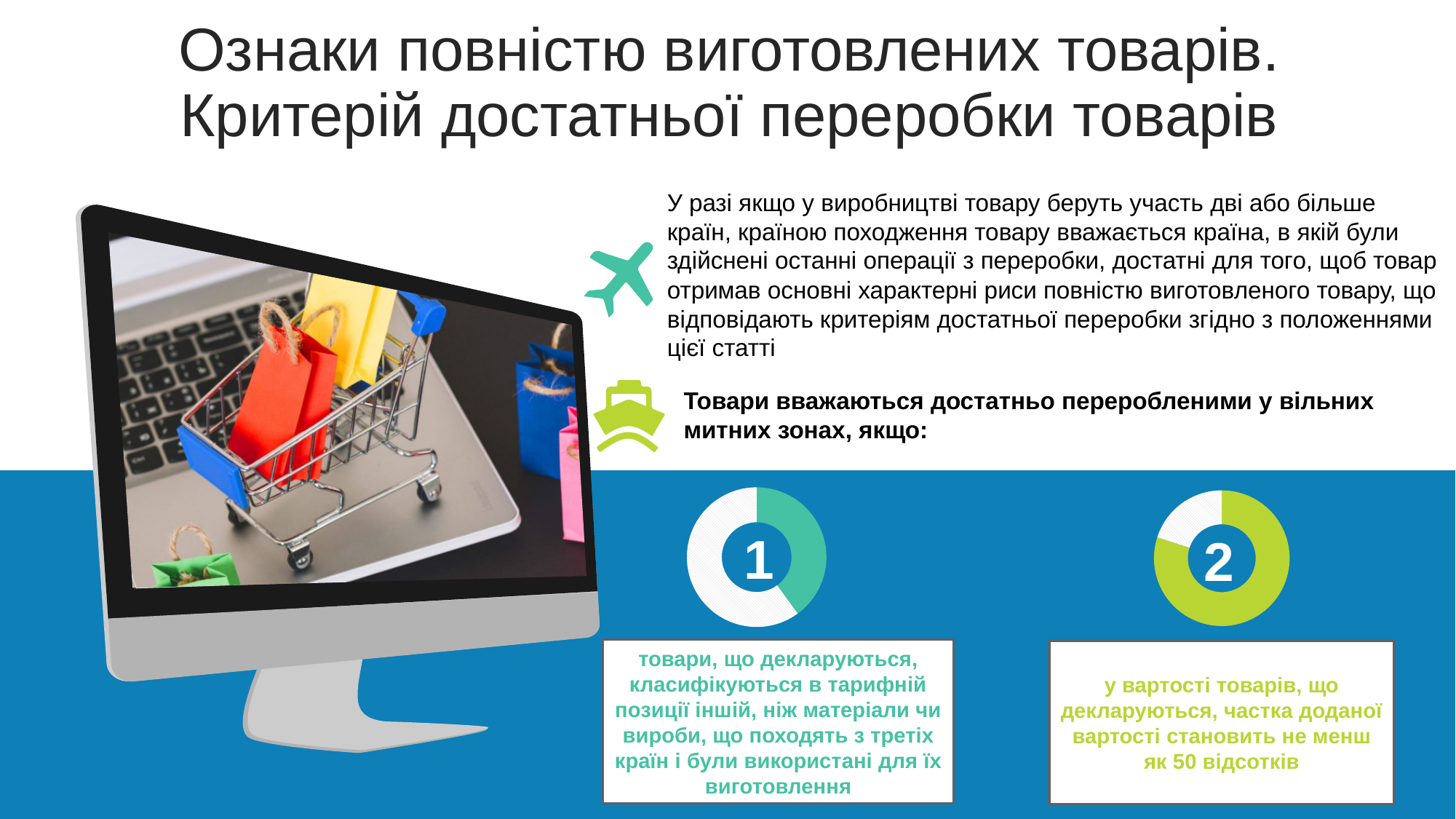
How many coloured segments does each donut chart have (excluding the white hatched remainder)? 1 Is the filled portion of the donut chart labelled 2 greater or less than half of the ring? greater What kind of chart is shown above the text box labelled 1 on the right side of the slide? Donut (pie) chart What number is printed in the centre of the right donut chart? 2 Which donut chart has the larger filled (coloured) portion, the one labelled 1 or the one labelled 2? 2 What number is printed in the centre of the left donut chart? 1 How many donut charts are on the slide? 2 Is the filled portion of the donut chart labelled 1 greater or less than half of the ring? less